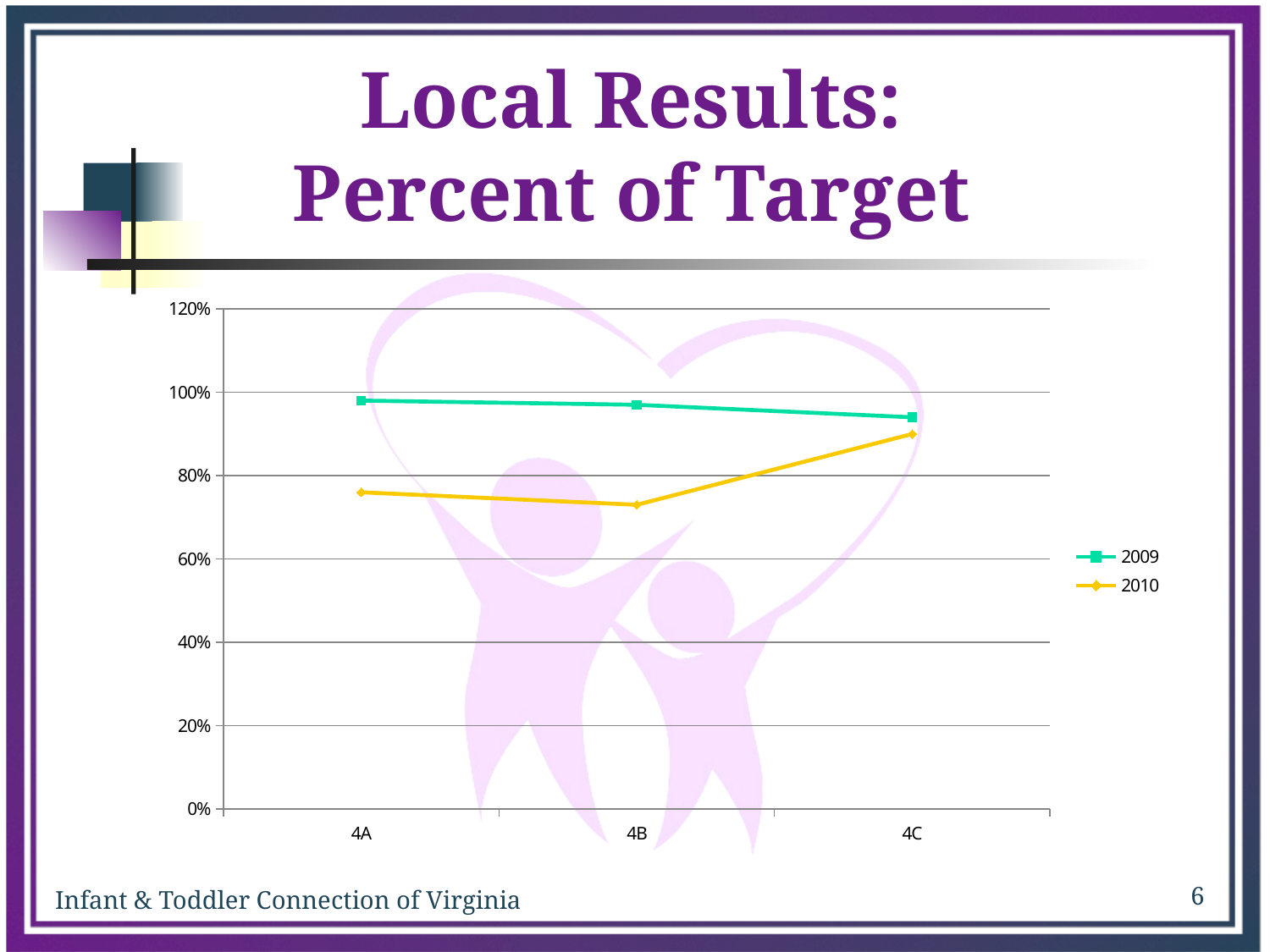
For the 2010 series, which category has the highest value? 4C Does the 2009 series rise or fall from 4A to 4C? fall Is the value for 2009 at 4A greater or less than 80%? greater What is the title of the slide containing the chart? Local Results: Percent of Target How many series does the legend list? 2 At 4B, which series has the larger value, 2009 or 2010? 2009 Is the value for 2010 at 4A greater or less than 80%? less How many categories are shown on the x axis? 3 Is the value for 2009 at 4C greater or less than 100%? less Which series does the legend list first? 2009 What kind of chart is shown on the slide? line chart